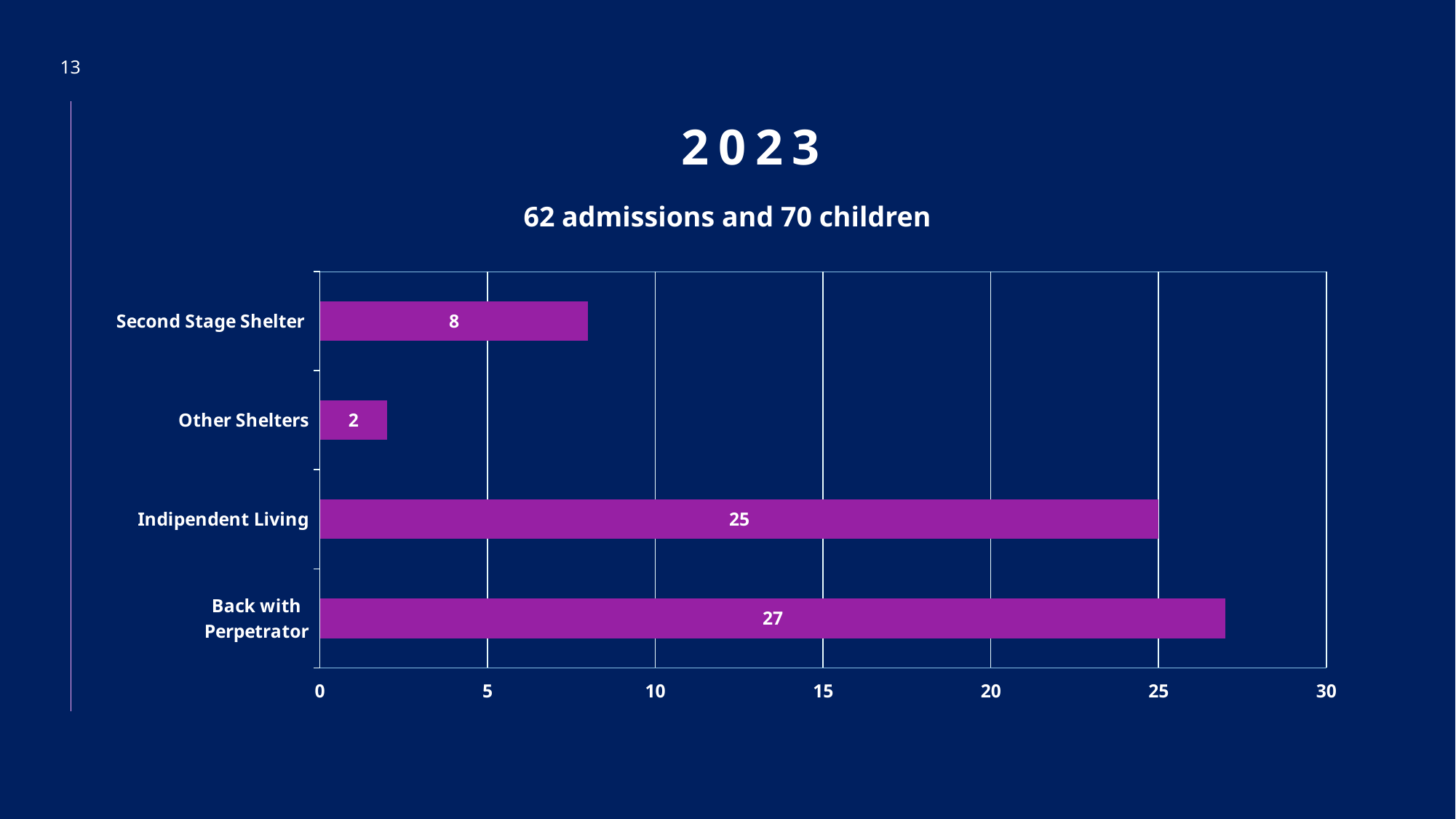
What is the value for Indipendent Living? 25 Which category has the highest value? Back with Perpetrator What is the value for Second Stage Shelter? 8 What kind of chart is shown on the slide? Bar chart Which category has the lowest value? Other Shelters Which is larger, the value for Second Stage Shelter or the value for Other Shelters? Second Stage Shelter Is the value for Indipendent Living greater or less than 20? greater What is the value for Back with Perpetrator? 27 How many categories are shown in the chart? 4 What is the difference between the values for Second Stage Shelter and Other Shelters? 6 What is the difference between the values for Back with Perpetrator and Indipendent Living? 2 What is the value for Other Shelters? 2